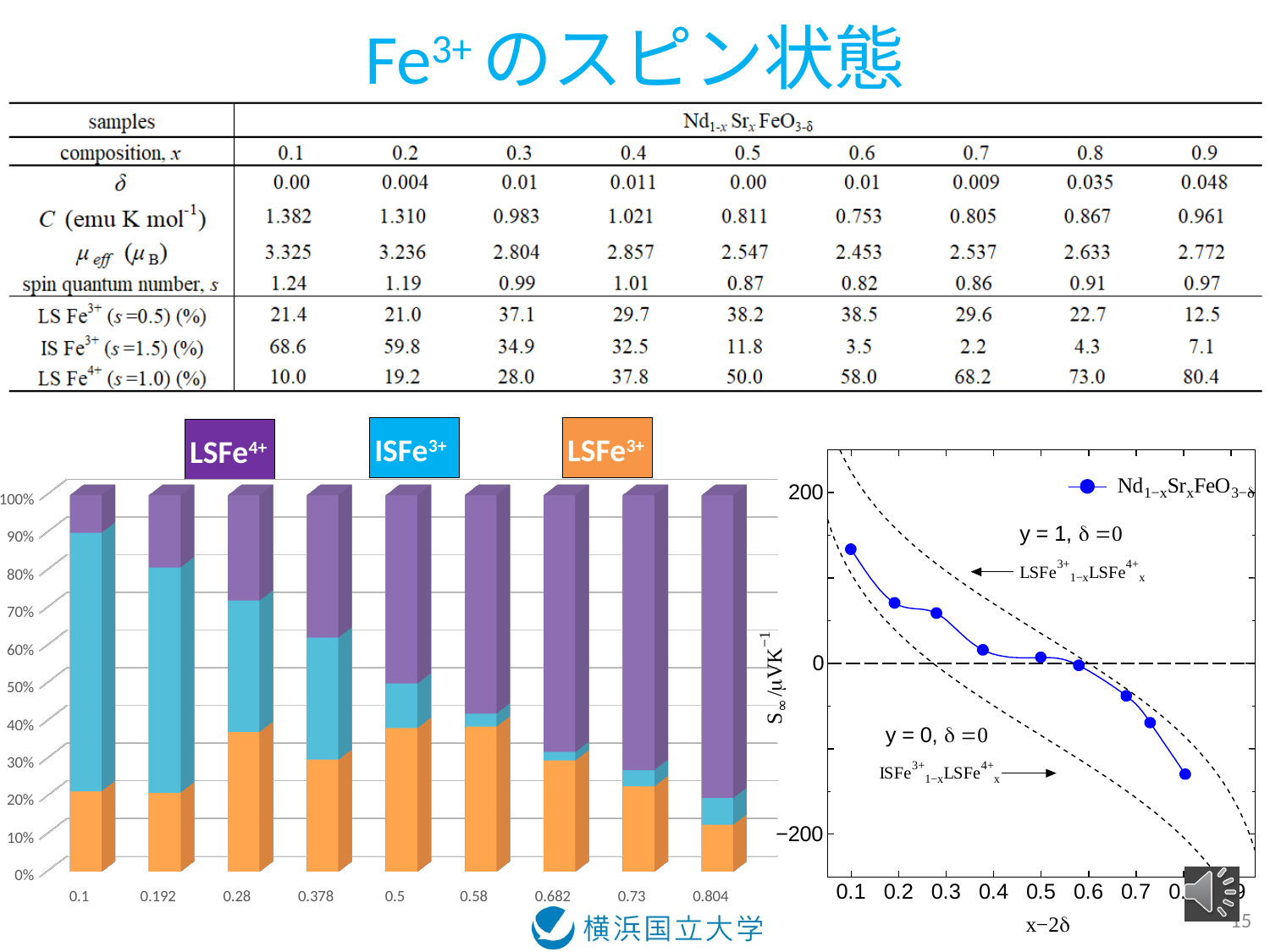
In the chart on the right, do the plotted values rise or fall as x−2δ increases? fall In the stacked bar chart on the left, is the orange (LSFe3+) segment for category 0.804 greater or less than 20%? less In the chart on the right, is the plotted value at x−2δ = 0.1 greater or less than 0? greater How many categories are shown on the x axis of the stacked bar chart on the left? 9 In the stacked bar chart on the left, does the purple (LSFe4+) share rise or fall from category 0.1 to category 0.804? rise In the chart on the right, how many plotted data points does the Nd1-xSrxFeO3-δ series have? 9 In the stacked bar chart on the left, which series is shown in purple? LSFe4+ How many series does the legend of the stacked bar chart on the left list? 3 In the stacked bar chart on the left, is the orange (LSFe3+) segment for category 0.1 greater or less than 30%? less In the stacked bar chart on the left, does the blue (ISFe3+) share rise or fall from category 0.1 to category 0.804? fall What kind of chart is the chart on the left of the slide? bar chart In the chart on the right, at which x−2δ value is the plotted S∞ value highest? 0.1